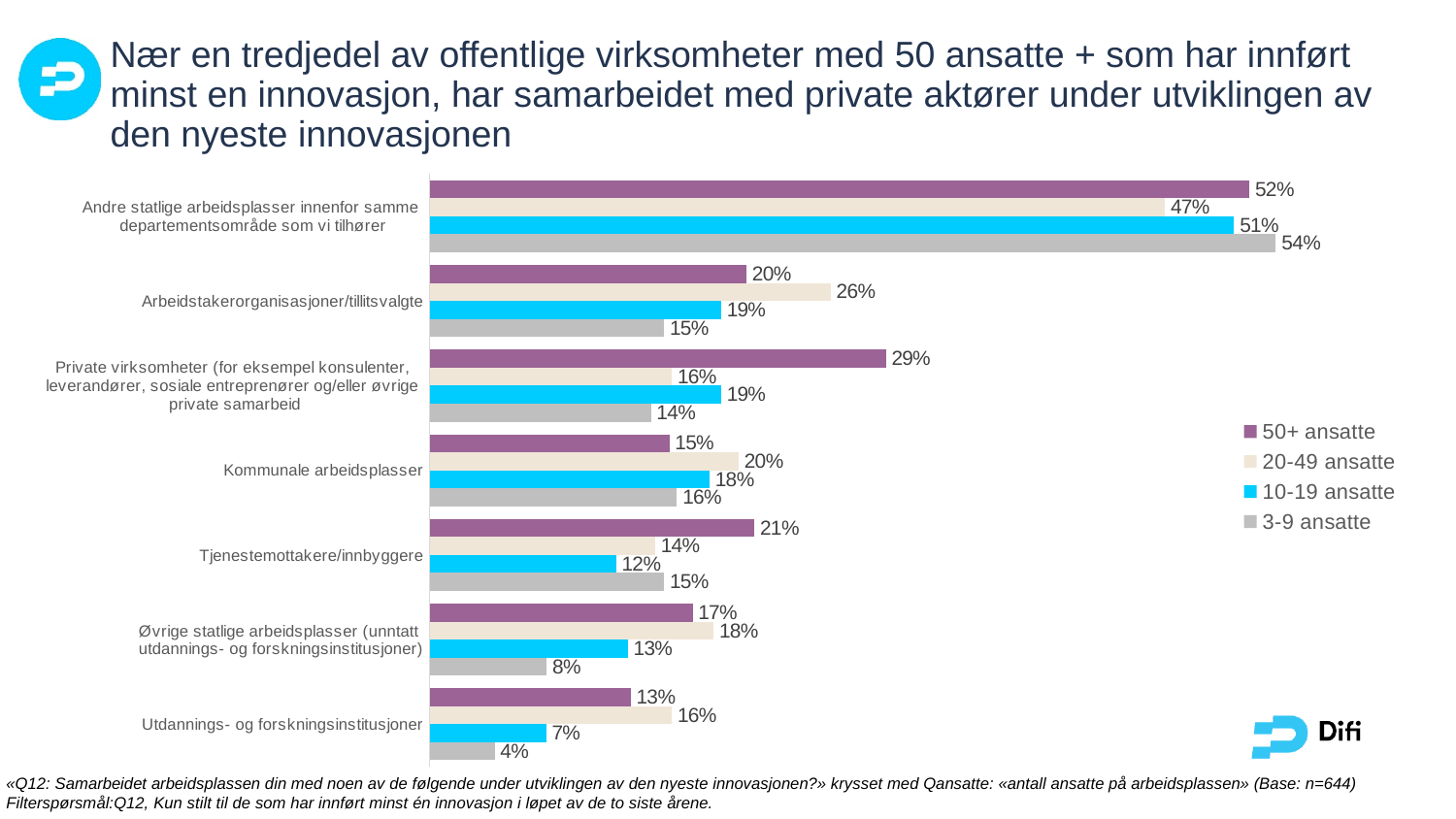
Which series has the highest value in the category 'Andre statlige arbeidsplasser innenfor samme departementsområde som vi tilhører'? 3-9 ansatte What is the value for '20-49 ansatte' in the category 'Arbeidstakerorganisasjoner/tillitsvalgte'? 26% What kind of chart is shown on the slide? Bar chart Which is larger for 'Kommunale arbeidsplasser': the value for '50+ ansatte' or the value for '20-49 ansatte'? 20-49 ansatte How many categories are shown on the chart? 7 Which series has the lowest value in the category 'Øvrige statlige arbeidsplasser (unntatt utdannings- og forskningsinstitusjoner)'? 3-9 ansatte What is the value for '3-9 ansatte' in the category 'Utdannings- og forskningsinstitusjoner'? 4% What is the value for '50+ ansatte' in the category 'Private virksomheter (for eksempel konsulenter, leverandører, sosiale entreprenører og/eller øvrige private samarbeid'? 29% Which category has the highest value for '50+ ansatte'? Andre statlige arbeidsplasser innenfor samme departementsområde som vi tilhører What colour represents the '10-19 ansatte' series in the legend? Blue What is the difference between the '50+ ansatte' and '3-9 ansatte' values for 'Private virksomheter (for eksempel konsulenter, leverandører, sosiale entreprenører og/eller øvrige private samarbeid'? 15% How many series does the legend list? 4